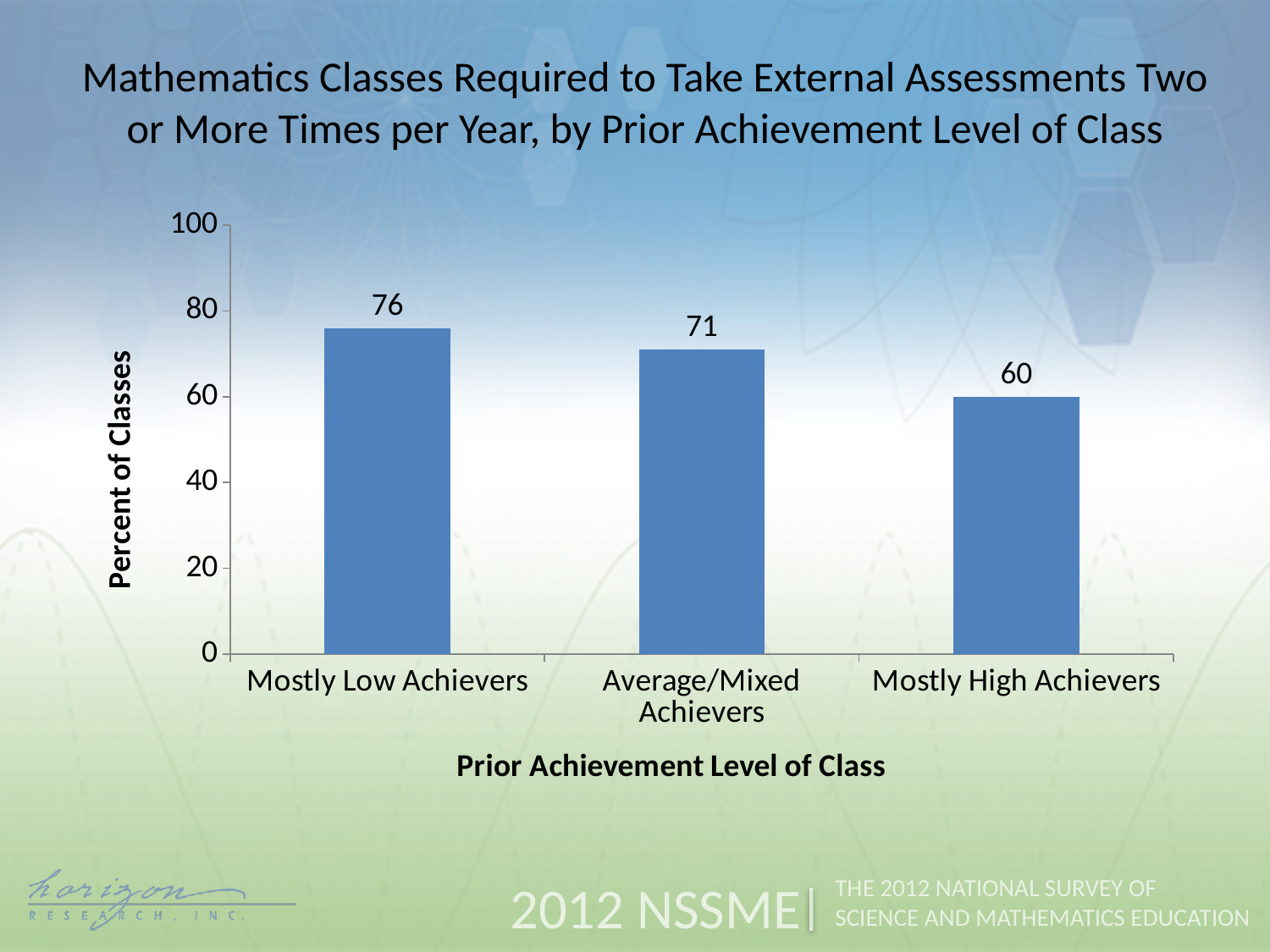
What kind of chart is shown on the slide? bar chart Which category has the lowest value? Mostly High Achievers Which category has the highest value? Mostly Low Achievers Which is larger, the value for Average/Mixed Achievers or Mostly High Achievers? Average/Mixed Achievers Is the value for Mostly High Achievers greater or less than 80? less What is the difference between the values for Mostly Low Achievers and Average/Mixed Achievers? 5 What is the label of the y axis? Percent of Classes What is the value for Average/Mixed Achievers? 71 What is the value for Mostly Low Achievers? 76 What is the value for Mostly High Achievers? 60 What is the difference between the values for Mostly Low Achievers and Mostly High Achievers? 16 How many categories are shown on the x axis? 3